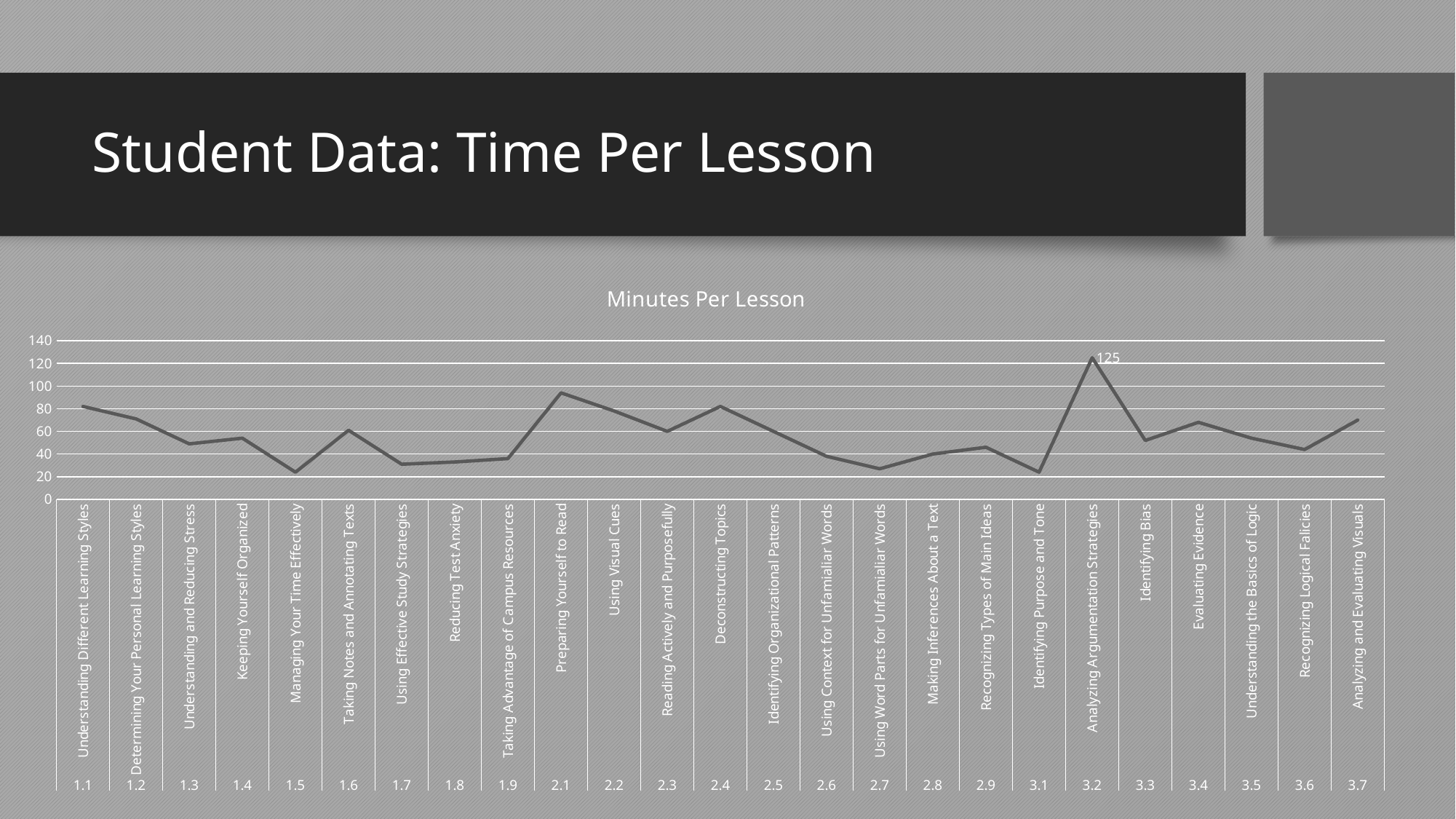
Which has the larger value: Preparing Yourself to Read (2.1) or Reducing Test Anxiety (1.8)? Preparing Yourself to Read What kind of chart is shown on the slide? line chart Which has the larger value: Understanding Different Learning Styles (1.1) or Understanding and Reducing Stress (1.3)? Understanding Different Learning Styles What is the value shown for lesson 3.2, Analyzing Argumentation Strategies? 125 Is the value for Managing Your Time Effectively (1.5) greater or less than 40? less Is the value for Identifying Purpose and Tone (3.1) greater or less than 40? less Which lesson has the highest minutes per lesson? Analyzing Argumentation Strategies (3.2) Is the value for Deconstructing Topics (2.4) greater or less than 60? greater Do the values rise or fall from lesson 1.1 to lesson 1.5? fall What is the title of the chart? Minutes Per Lesson How many lessons are plotted on the x axis of the chart? 25